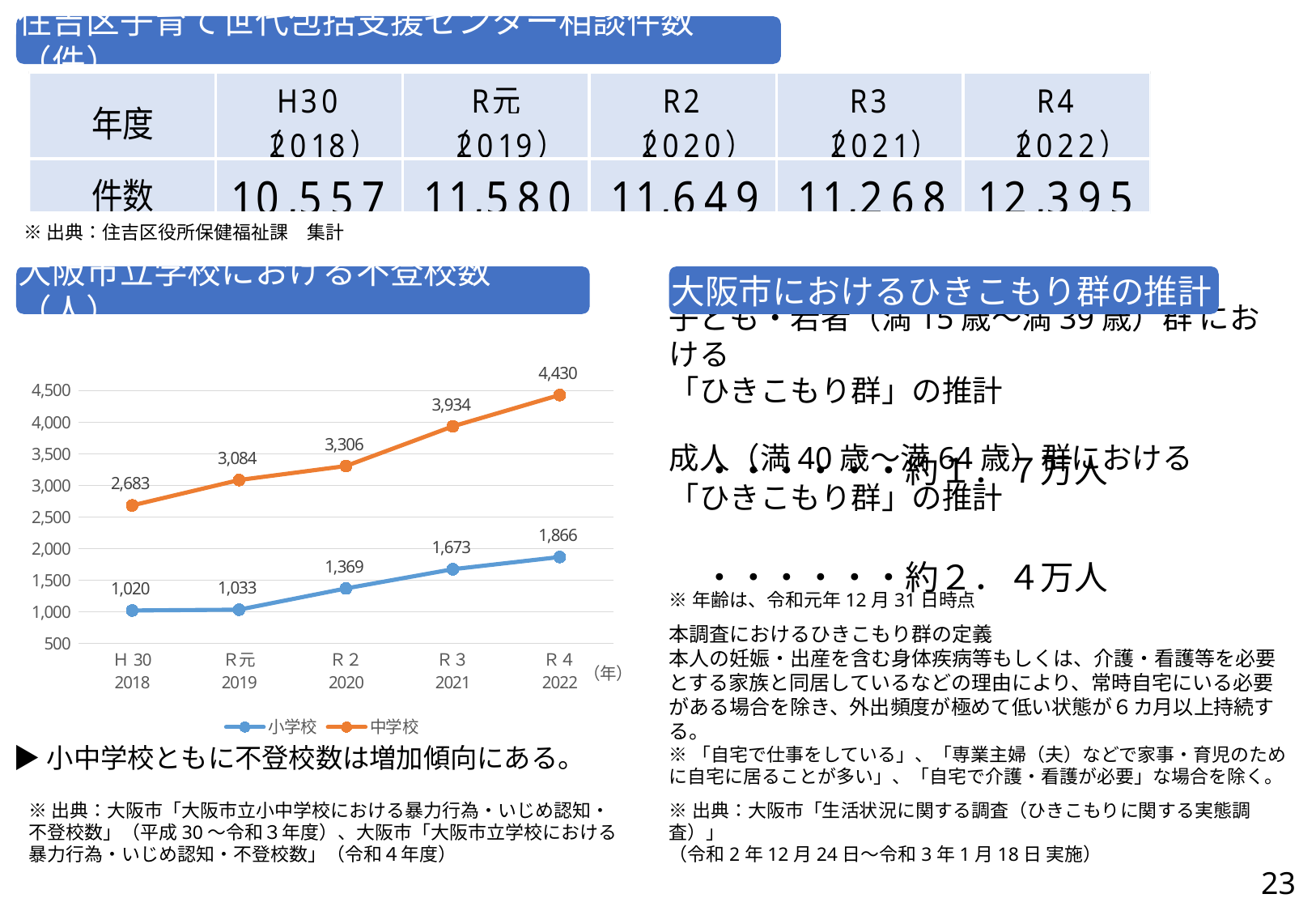
What is the value for 中学校 in R4 (2022)? 4,430 What is the value for 小学校 in H30 (2018)? 1,020 What is the value for 中学校 in R2 (2020)? 3,306 Which is larger in R元 (2019): the 小学校 value or the 中学校 value? 中学校 In which year is the 中学校 value lowest? H30 (2018) What is the value for 小学校 in R3 (2021)? 1,673 In which year is the 小学校 value highest? R4 (2022) Does the 中学校 series rise or fall from H30 (2018) to R4 (2022)? rise How many series does the chart legend list? 2 How many years are plotted on the x axis? 5 What is the difference between the 中学校 and 小学校 values in R4 (2022)? 2,564 What type of chart is shown on the slide? line chart